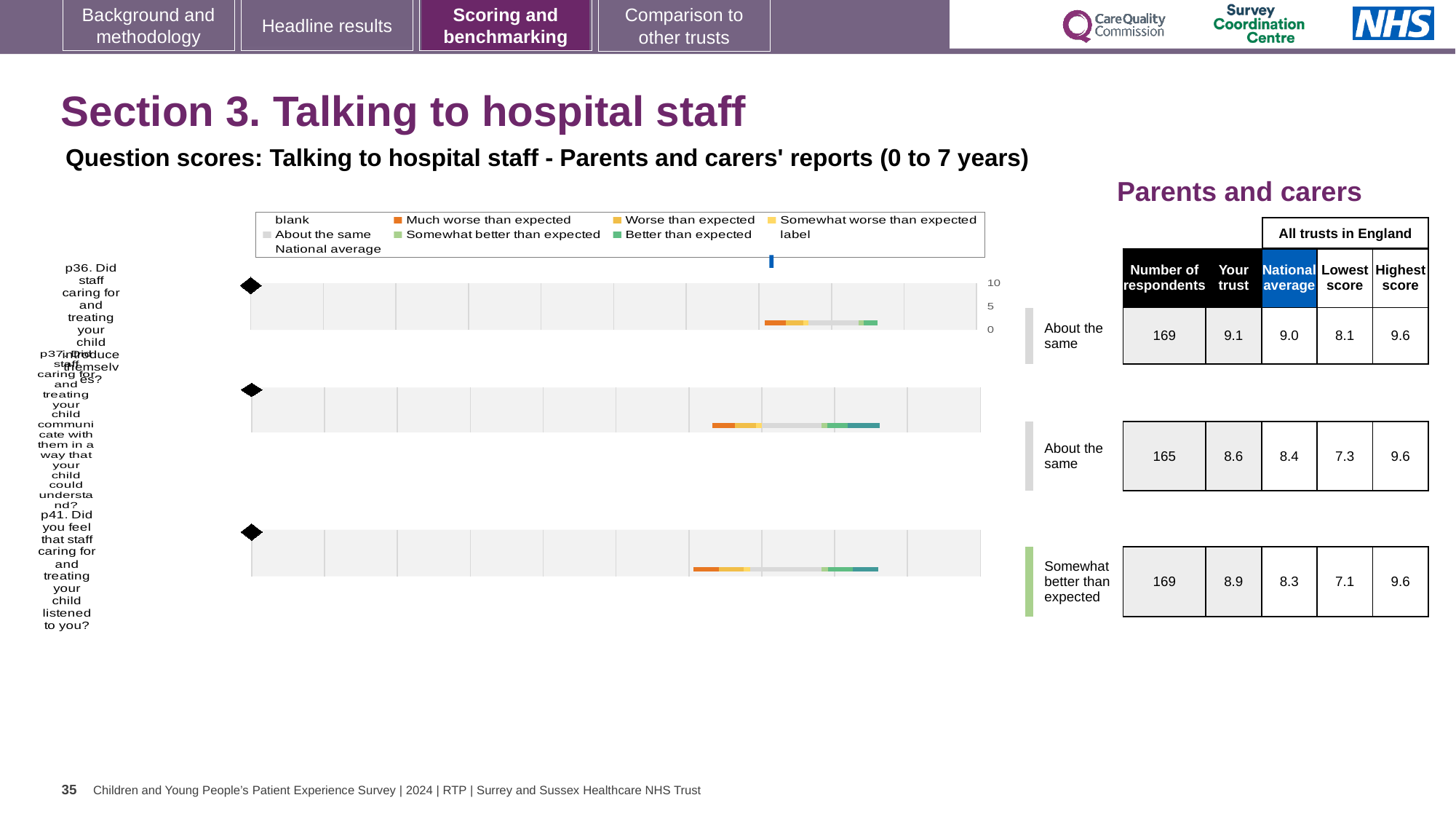
In the table beside the chart, which is larger for the third row (p41): the 'Your trust' score or the 'National average'? Your trust How many entries does the chart legend list? 9 What colour does the legend use for 'Much worse than expected'? orange What benchmark label is given for the third row (p41)? Somewhat better than expected In the table beside the chart, what is the 'Your trust' score in the first row (p36)? 9.1 In the table beside the chart, which row has the highest 'Your trust' score? first row (p36), 9.1 In the table beside the chart, what is the difference between the highest score and the lowest score in the first row (p36)? 1.5 In the table beside the chart, what is the number of respondents in the second row (p37)? 165 What kind of chart is shown on the slide? bar chart How many survey questions (categories) are plotted in the chart? 3 In the table beside the chart, what is the 'National average' in the second row (p37)? 8.4 What is the highest tick value shown on the chart's axis? 10